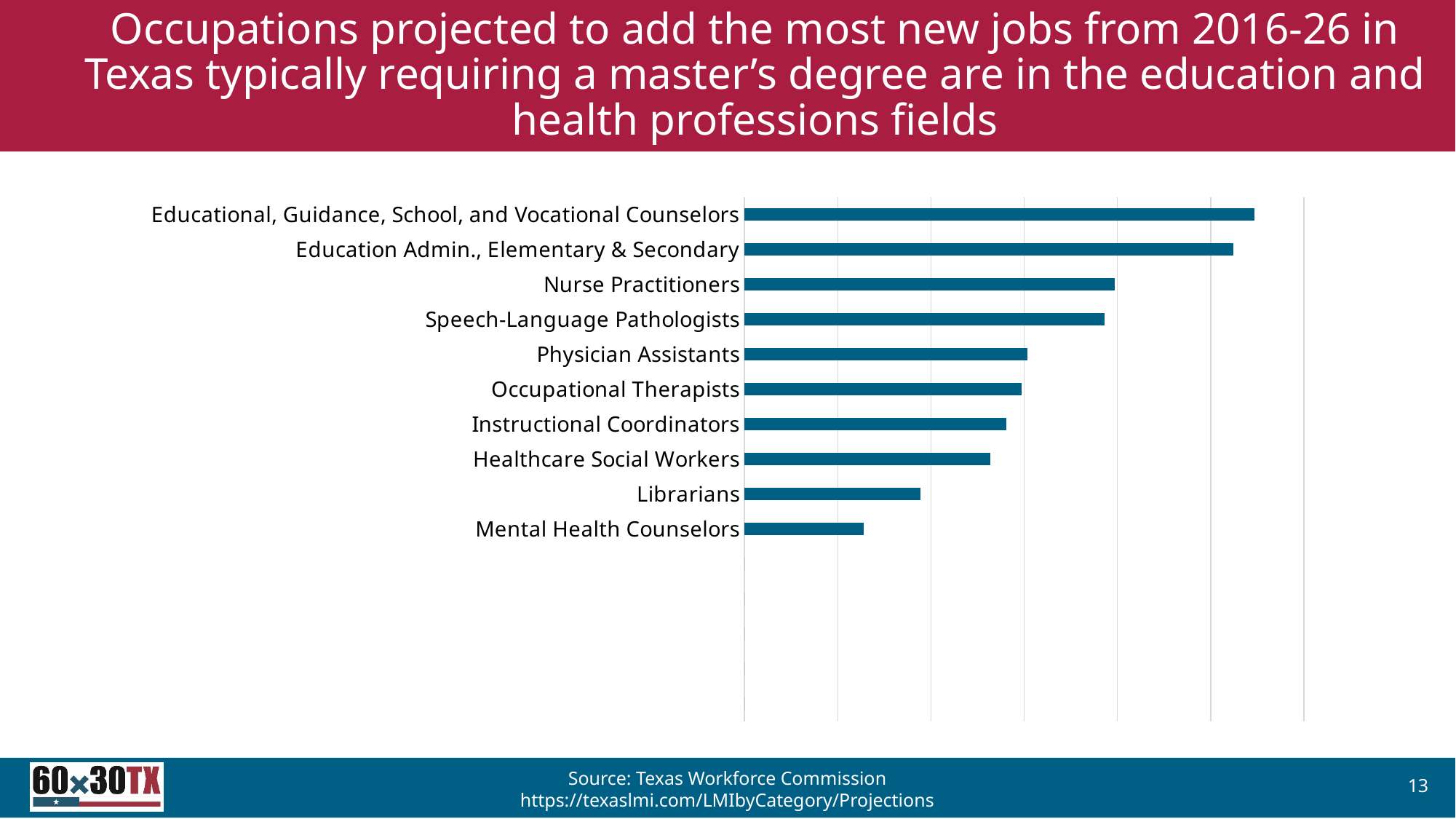
Do the bar lengths increase or decrease going from the top of the chart to the bottom? Decrease Which has the larger value, Instructional Coordinators or Mental Health Counselors? Instructional Coordinators What kind of chart is shown on the slide? Bar chart Which has the larger value, Education Admin., Elementary & Secondary or Physician Assistants? Education Admin., Elementary & Secondary What source is cited for the chart data? Texas Workforce Commission Which has the larger value, Speech-Language Pathologists or Healthcare Social Workers? Speech-Language Pathologists Which occupation has the shortest bar in the chart? Mental Health Counselors Which occupation has the longest bar in the chart? Educational, Guidance, School, and Vocational Counselors How many occupations are listed in the chart? 10 Which occupation is listed second from the top of the chart? Education Admin., Elementary & Secondary